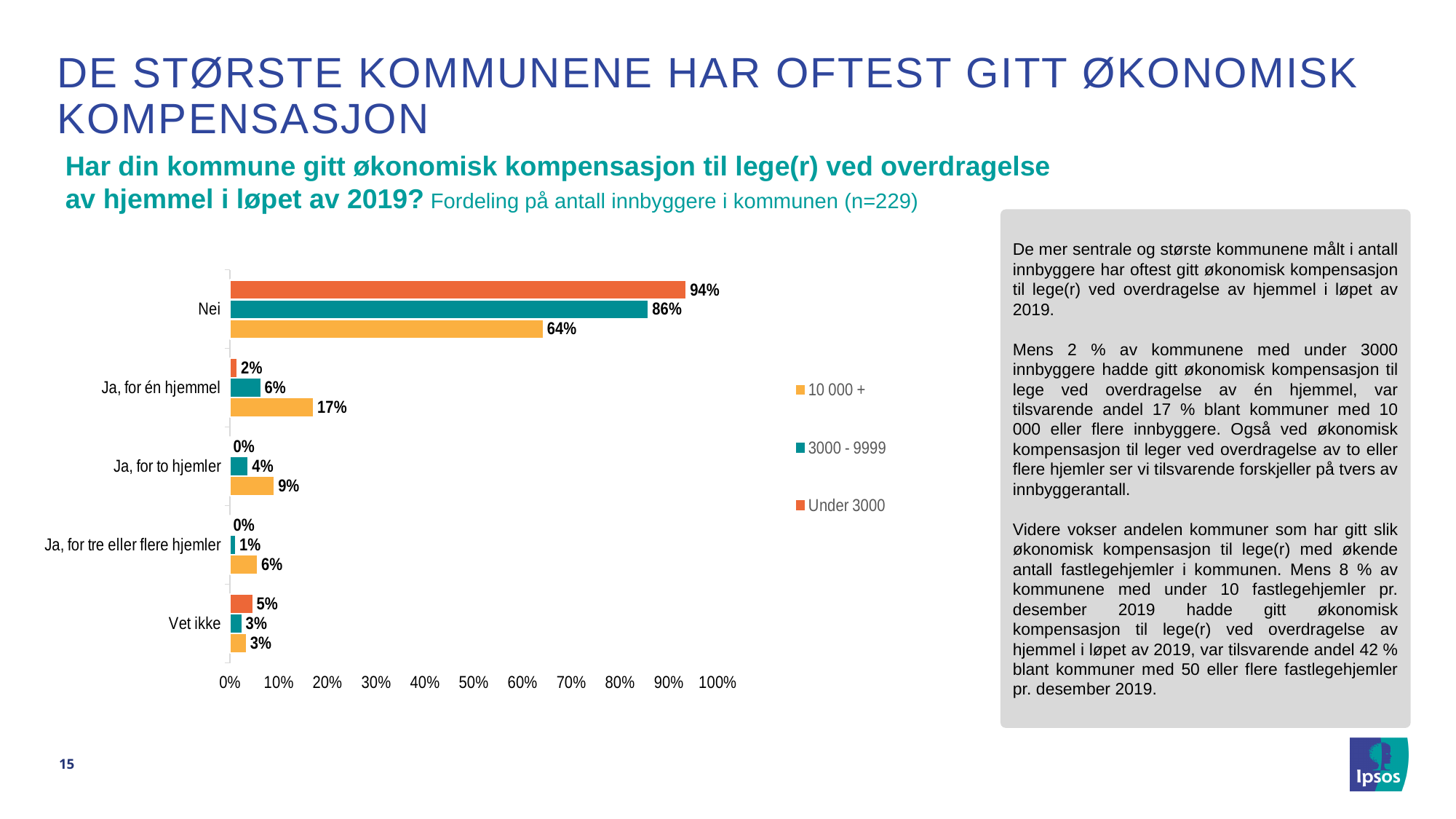
What is the value for 'Ja, for én hjemmel' in the '10 000 +' series? 17% What is the value for 'Nei' in the 'Under 3000' series? 94% What is the value for 'Nei' in the '10 000 +' series? 64% How many series does the legend list? 3 For 'Ja, for én hjemmel', which is larger: the '10 000 +' value or the '3000 - 9999' value? 10 000 + How many categories are shown on the chart? 5 What kind of chart is shown on the slide? bar chart Which series has the highest value for 'Nei'? Under 3000 What is the value for 'Vet ikke' in the 'Under 3000' series? 5% What is the value for 'Ja, for to hjemler' in the '3000 - 9999' series? 4% Which colour represents the 'Under 3000' series in the legend? orange What is the difference between the 'Under 3000' and '10 000 +' values for 'Nei'? 30%